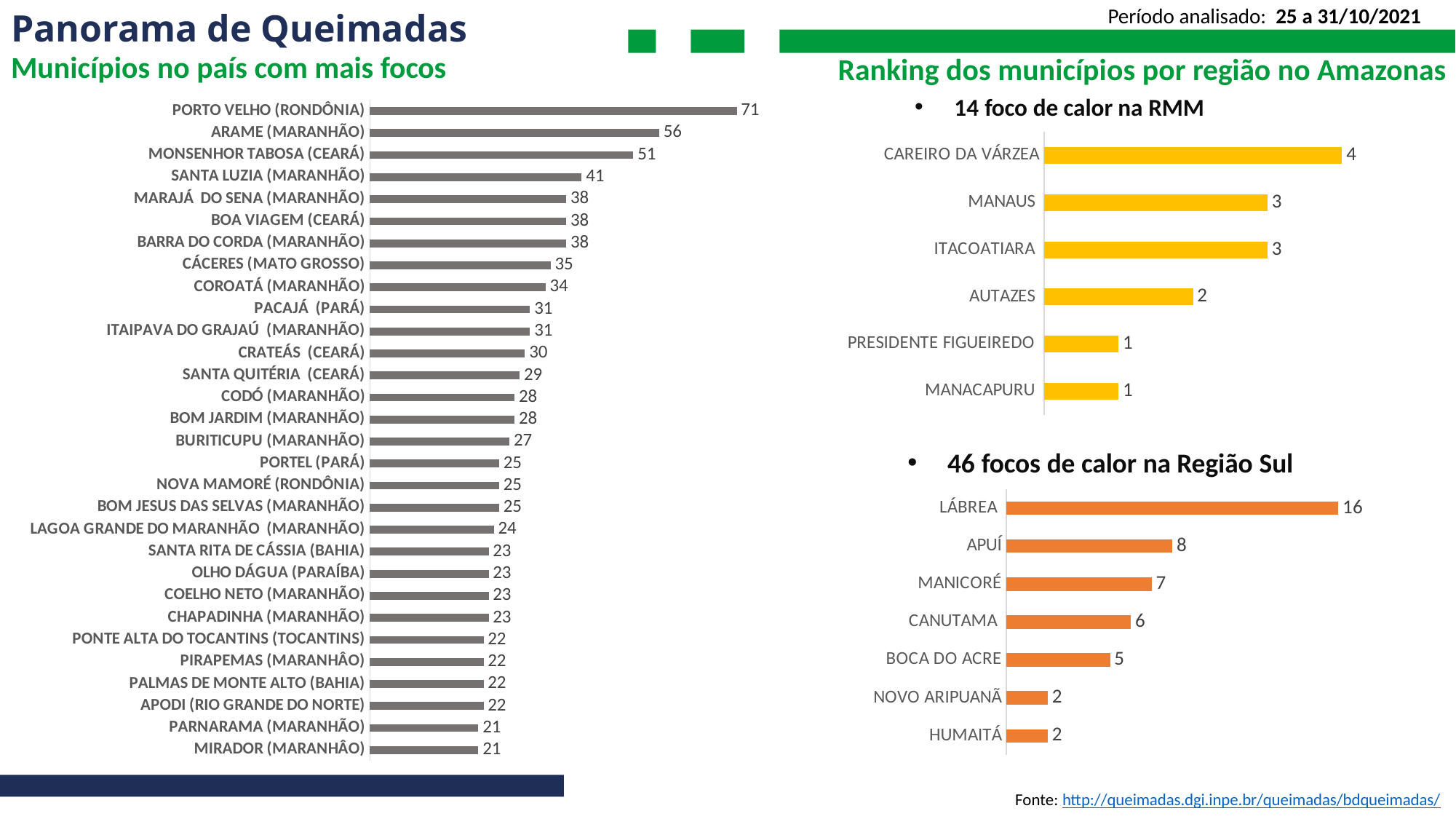
In the 'Municípios no país com mais focos' chart, what is the value for PORTO VELHO (RONDÔNIA)? 71 In the 'Municípios no país com mais focos' chart, which municipality has the highest value? PORTO VELHO (RONDÔNIA) In the '46 focos de calor na Região Sul' chart, what is the difference between LÁBREA and BOCA DO ACRE? 11 What type of chart is the '46 focos de calor na Região Sul' chart? Bar chart In the '14 foco de calor na RMM' chart, which municipality has the highest value? CAREIRO DA VÁRZEA How many municipalities are listed in the 'Municípios no país com mais focos' chart? 30 In the '46 focos de calor na Região Sul' chart, which is larger: APUÍ or MANICORÉ? APUÍ In the '14 foco de calor na RMM' chart, what is the value for AUTAZES? 2 In the 'Municípios no país com mais focos' chart, what is the difference between ARAME (MARANHÃO) and MONSENHOR TABOSA (CEARÁ)? 5 How many municipalities are shown in the '14 foco de calor na RMM' chart? 6 In the 'Municípios no país com mais focos' chart, what is the value for CÁCERES (MATO GROSSO)? 35 In the '46 focos de calor na Região Sul' chart, what is the value for LÁBREA? 16